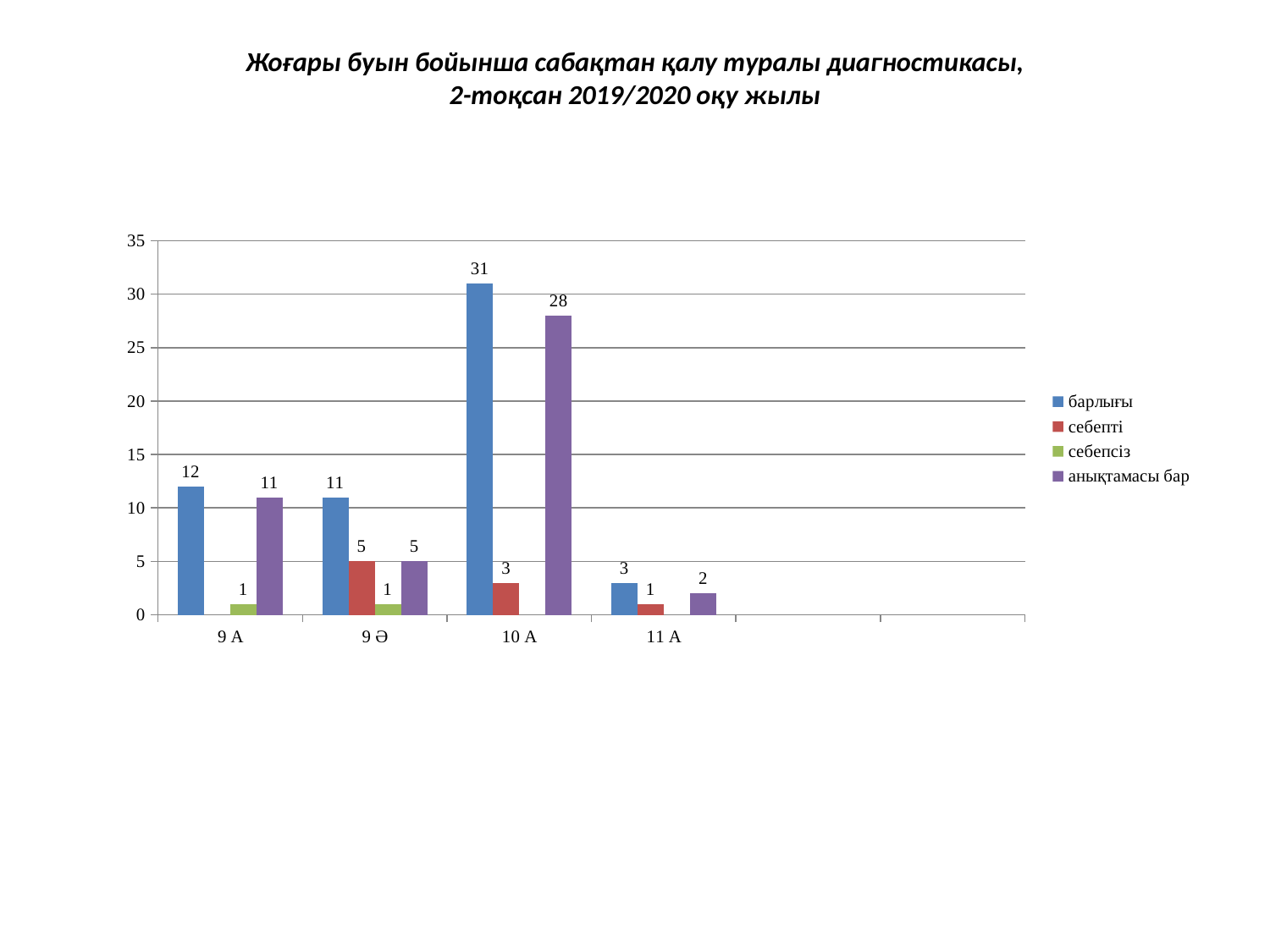
What is the value of анықтамасы бар for 9 А? 11 What is the difference between барлығы and анықтамасы бар for 10 А? 3 Which class has the highest барлығы value? 10 А What colour are the bars for the series анықтамасы бар? purple What kind of chart is shown on the slide? bar chart Is the барлығы value for 10 А greater or less than 30? greater Which class has the lowest барлығы value? 11 А Which is larger for 9 Ә: барлығы or анықтамасы бар? барлығы What is the value of анықтамасы бар for 11 А? 2 What is the value of себепті for 9 Ә? 5 How many series does the legend list? 4 What is the value of барлығы for 10 А? 31